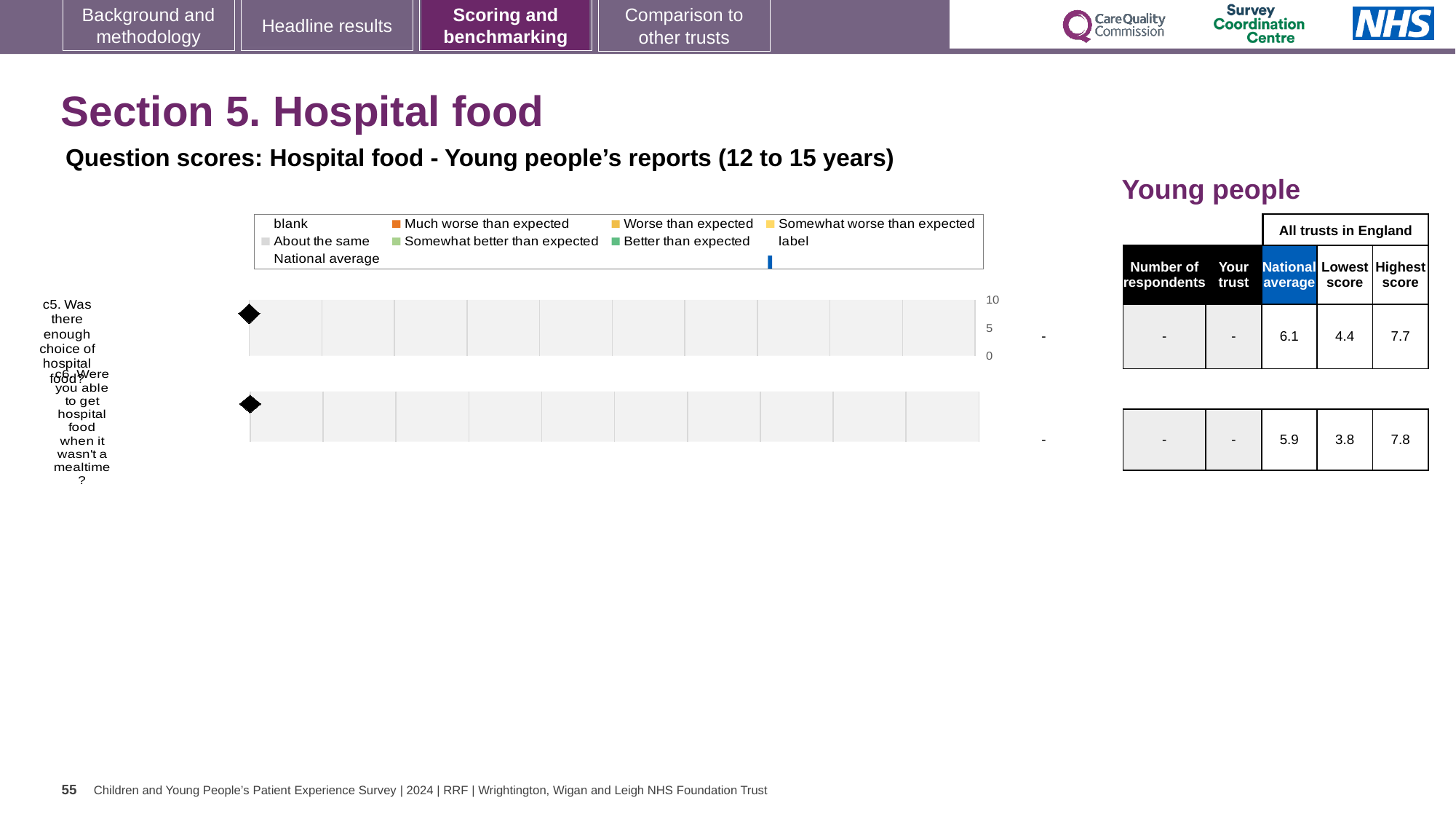
What is the difference between the highest and lowest scores for c6? 4.0 Which question has the higher national average, c5 or c6? c5 Which question has the lower lowest score across all trusts, c5 or c6? c6 What is shown as the 'Your trust' score for c5? - What is the maximum value shown on the chart's score axis? 10 In the table, what is the highest score across all trusts in England for c6 'Were you able to get hospital food when it wasn't a mealtime?'? 7.8 What colour does the legend use for 'Much worse than expected'? orange How many questions (categories) are listed on the chart's vertical axis? 2 What kind of chart is shown on the slide? bar chart In the table, what is the lowest score across all trusts in England for c5? 4.4 In the table, what is the national average score for c5 'Was there enough choice of hospital food?'? 6.1